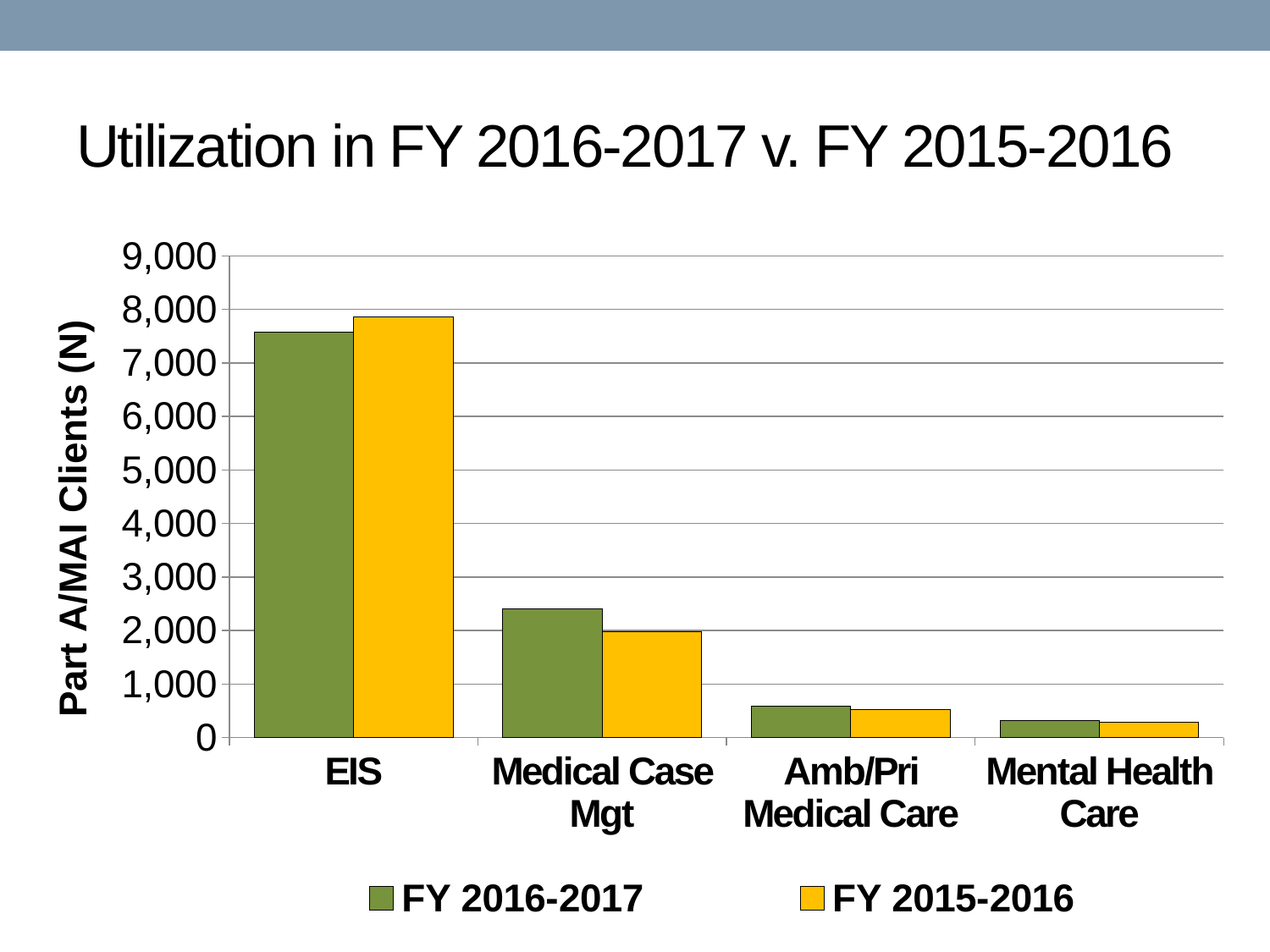
Is the FY 2016-2017 value for Amb/Pri Medical Care greater or less than 1,000? less Which category has the highest number of Part A/MAI clients for FY 2016-2017? EIS Is the FY 2015-2016 value for EIS greater or less than 8,000? less How many categories are shown on the x axis of the chart? 4 For EIS, which series has the larger value, FY 2016-2017 or FY 2015-2016? FY 2015-2016 Which category has the lowest number of Part A/MAI clients for FY 2015-2016? Mental Health Care What kind of chart is shown on the slide? bar chart How many series does the chart's legend list? 2 Do the FY 2016-2017 values rise or fall moving from EIS to Mental Health Care along the x axis? fall For Medical Case Mgt, which series has the larger value, FY 2016-2017 or FY 2015-2016? FY 2016-2017 Is the FY 2016-2017 value for EIS greater or less than 7,000? greater